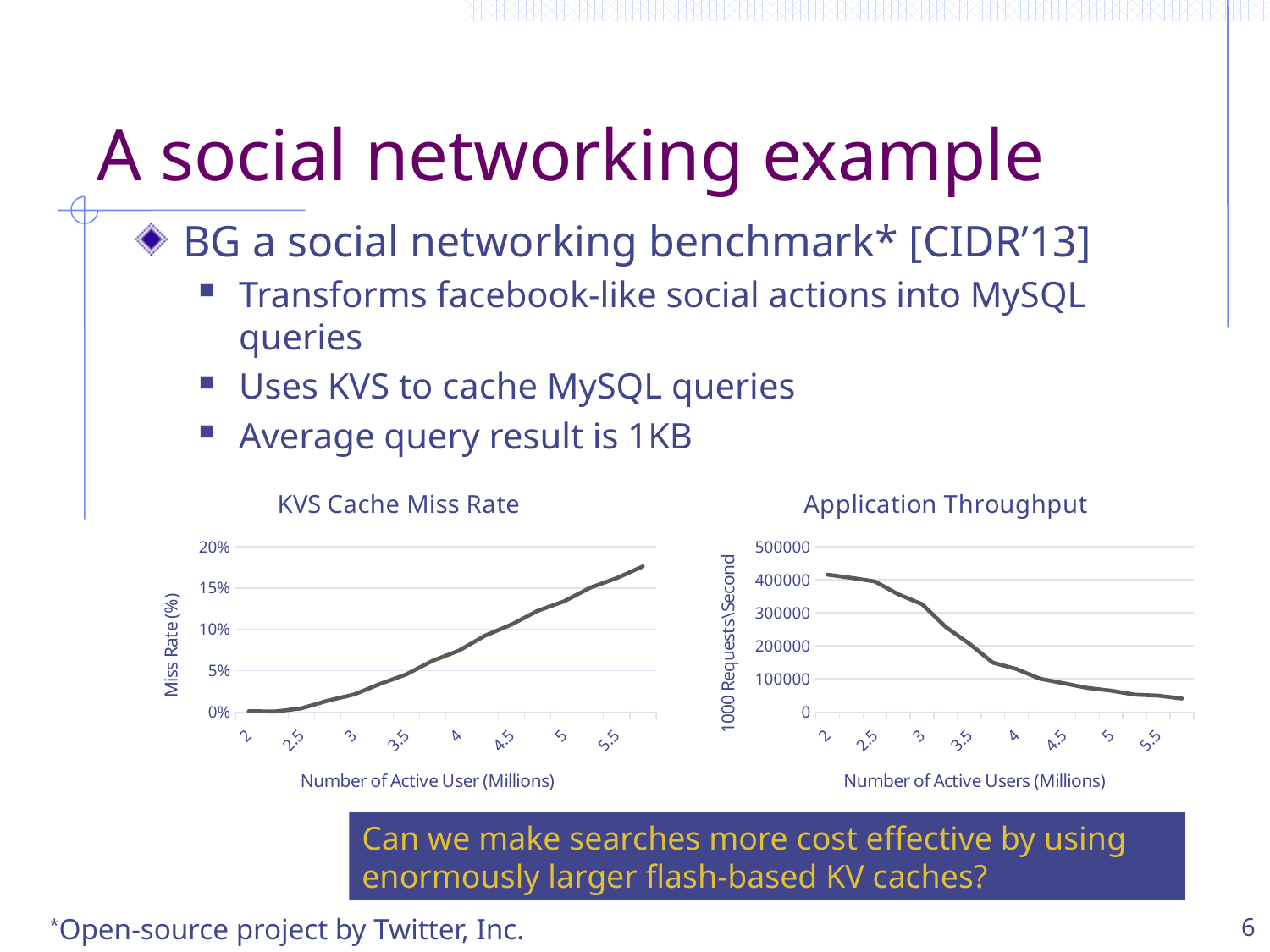
In the KVS Cache Miss Rate chart, does the miss rate rise or fall as the number of active users increases? rise In the KVS Cache Miss Rate chart, is the miss rate at 4 million active users greater or less than 5%? greater In the Application Throughput chart, is the throughput at 5.5 million active users greater or less than 100000? less What is the x-axis label of the KVS Cache Miss Rate chart? Number of Active User (Millions) In the Application Throughput chart, does throughput rise or fall as the number of active users increases? fall In the KVS Cache Miss Rate chart, is the miss rate at 2 million active users greater or less than 5%? less What kind of chart is the Application Throughput chart? line chart What is the y-axis label of the Application Throughput chart? 1000 Requests\Second What kind of chart is the KVS Cache Miss Rate chart? line chart